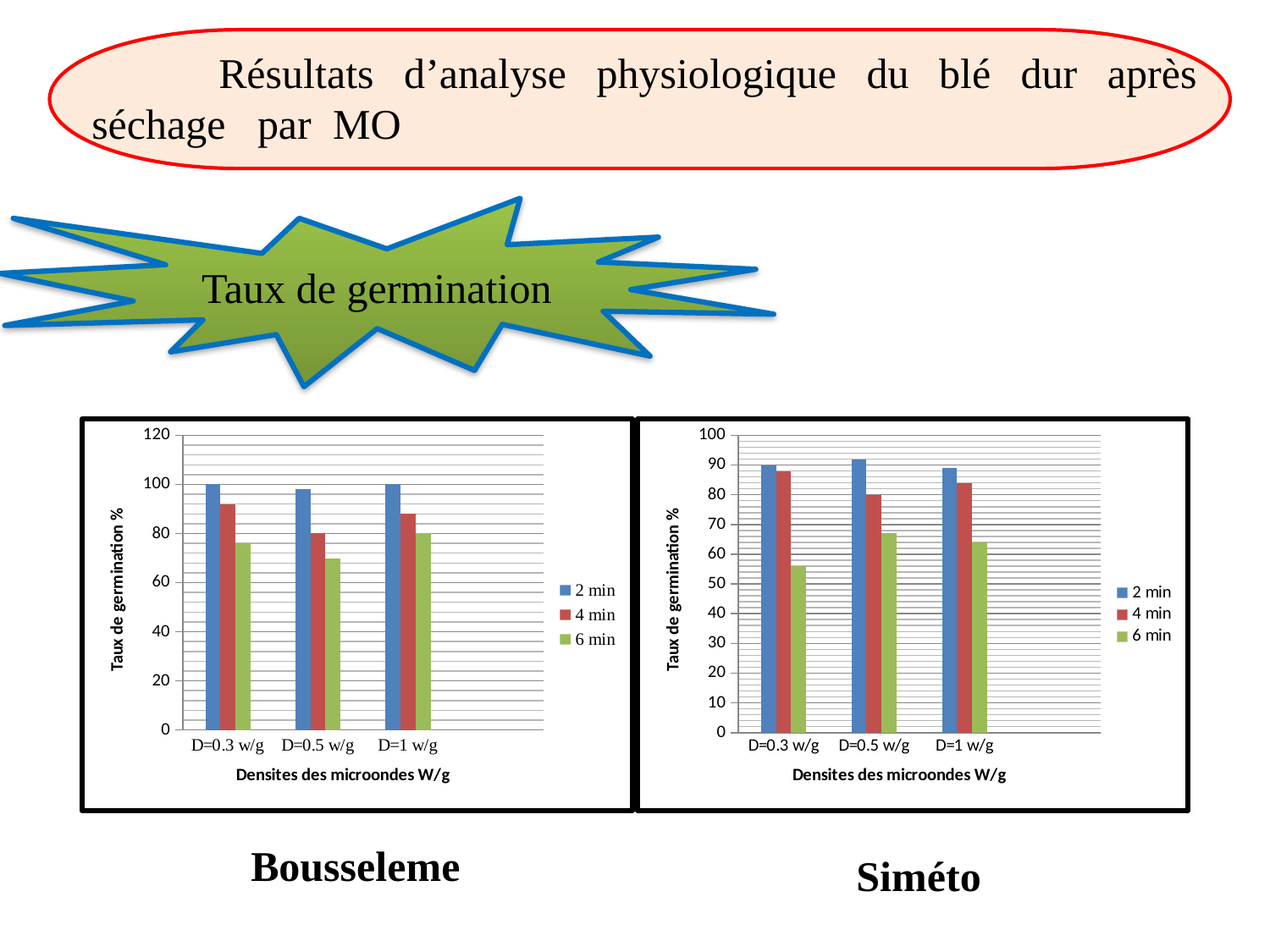
In the Bousseleme chart, is the value for 6 min at D=0.5 w/g greater or less than 80? less What kind of chart is the Bousseleme chart on the left? bar chart In the Bousseleme chart, which exposure time has the highest germination rate at D=0.5 w/g? 2 min In the Bousseleme chart, is the value for 4 min at D=0.3 w/g greater or less than 80? greater How many microwave density categories are shown on the x axis of the Bousseleme chart? 3 In the Siméto chart, what is the germination rate for 2 min at D=0.3 w/g? 90 In the Siméto chart, which exposure time has the lowest germination rate at D=0.3 w/g? 6 min In the Siméto chart, is the 6 min value larger at D=0.3 w/g or at D=0.5 w/g? D=0.5 w/g What is the x-axis title of the Siméto chart? Densites des microondes W/g In the Siméto chart, is the value for 6 min at D=0.3 w/g greater or less than 60? less How many series does the legend of the Siméto chart list? 3 In the Bousseleme chart, what is the germination rate for 2 min at D=0.3 w/g? 100